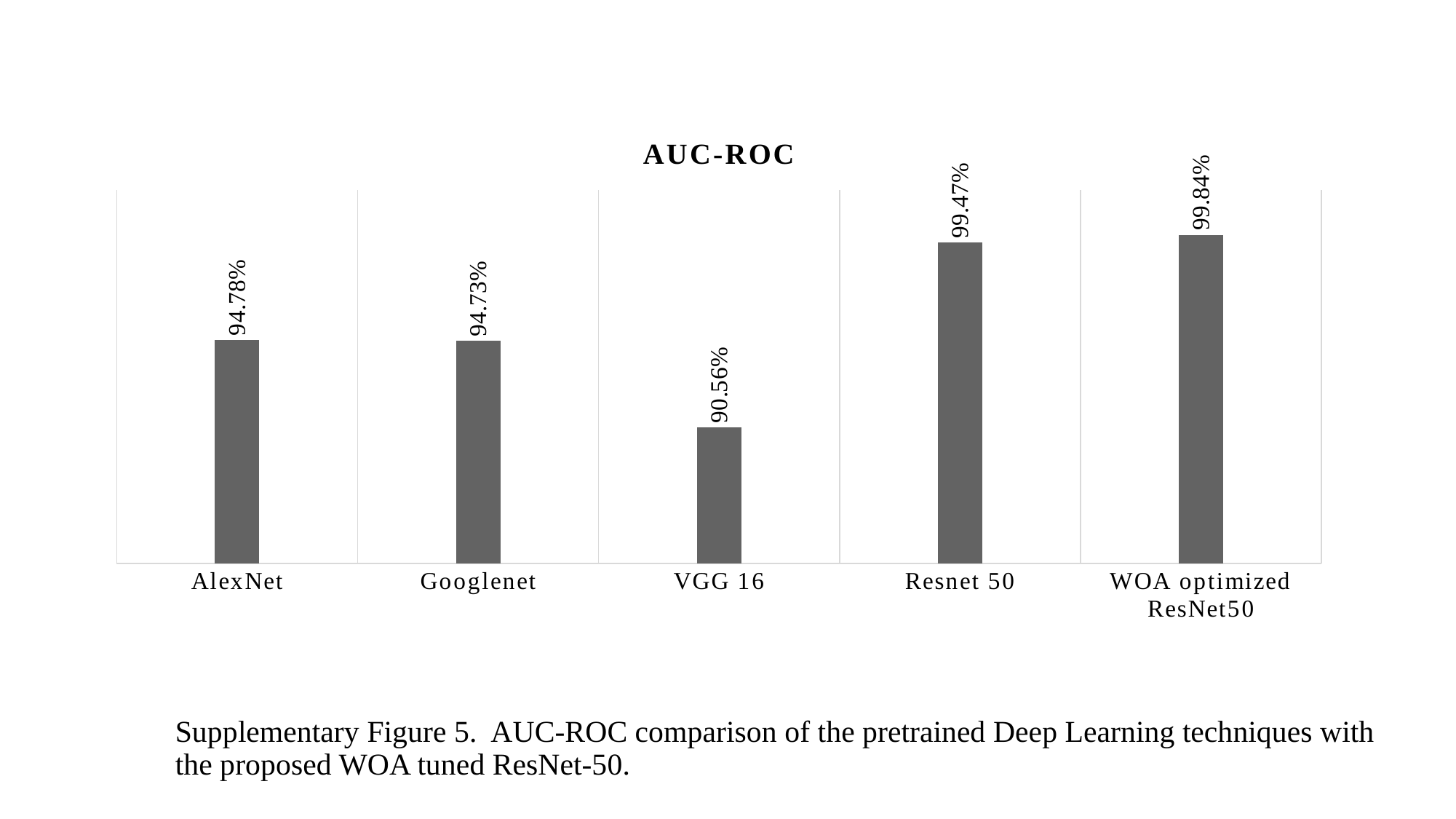
Which model has the lowest AUC-ROC? VGG 16 What is the AUC-ROC value for AlexNet? 94.78% Which has a higher AUC-ROC, VGG 16 or Resnet 50? Resnet 50 What is the AUC-ROC value for Googlenet? 94.73% What type of chart is shown on the slide? Bar chart Which model has the highest AUC-ROC? WOA optimized ResNet50 What is the difference in AUC-ROC between WOA optimized ResNet50 and Resnet 50? 0.37% What is the AUC-ROC value for Resnet 50? 99.47% What is the AUC-ROC value for VGG 16? 90.56% What is the AUC-ROC value for WOA optimized ResNet50? 99.84% What is the difference in AUC-ROC between Resnet 50 and VGG 16? 8.91% How many models are compared in the chart? 5